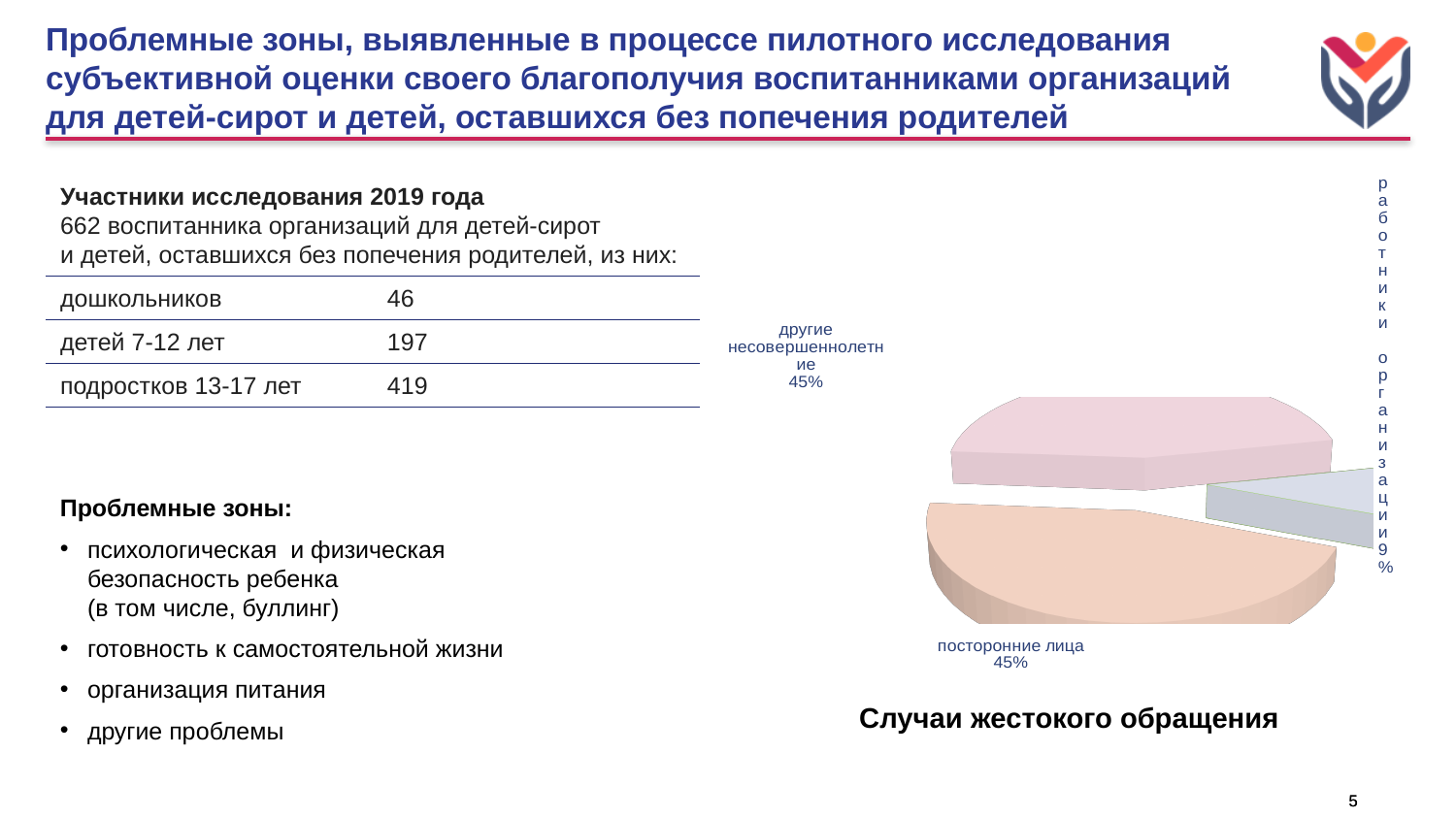
What share of the pie chart is labelled "другие несовершеннолетние"? 45% Which category has the smallest slice in the pie chart? работники организации Which slice is larger: "посторонние лица" or "работники организации"? посторонние лица Is the share for "работники организации" greater or less than 10%? less What kind of chart is shown on the slide? pie chart How many slices does the pie chart have? 3 What is the title of the chart on the slide? Случаи жестокого обращения What share of the pie chart is labelled "работники организации"? 9% What is the difference between the shares for "другие несовершеннолетние" and "работники организации"? 36% Do the slices "посторонние лица" and "другие несовершеннолетние" have the same share? yes What share of the pie chart is labelled "посторонние лица"? 45%